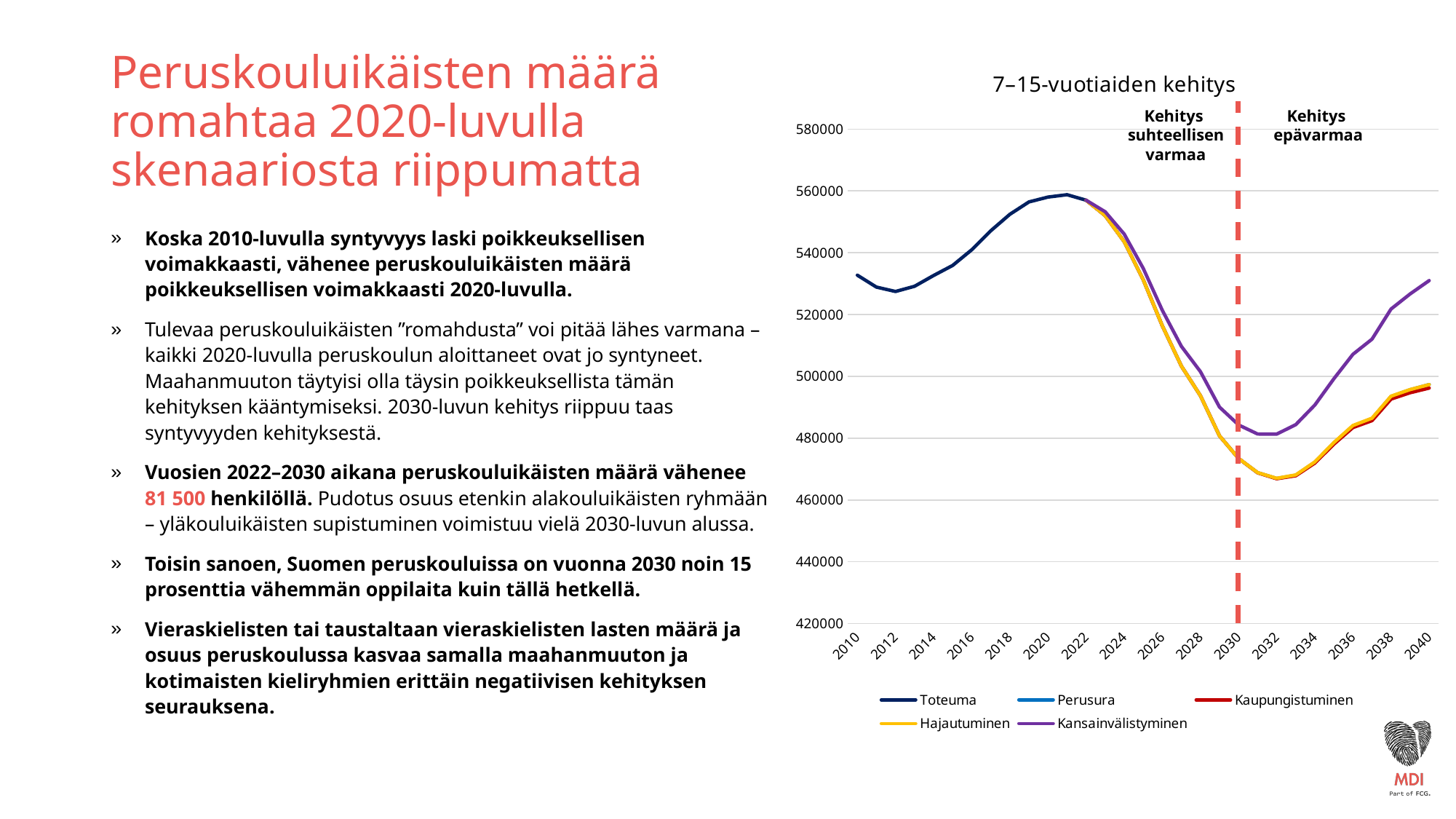
Is the value of Kaupungistuminen in 2040 greater or less than 500000? less Is the value of Kansainvälistyminen in 2040 greater or less than 520000? greater Which series has the highest value in 2040? Kansainvälistyminen In 2040, which is larger: Kansainvälistyminen or Hajautuminen? Kansainvälistyminen Is the value of Hajautuminen in 2032 greater or less than 480000? less Do the projected series rise or fall between 2022 and 2030? Fall What is the title of the chart? 7–15-vuotiaiden kehitys What kind of chart is shown on the slide? Line chart Which series is drawn in purple in the chart? Kansainvälistyminen How many series does the chart legend list? 5